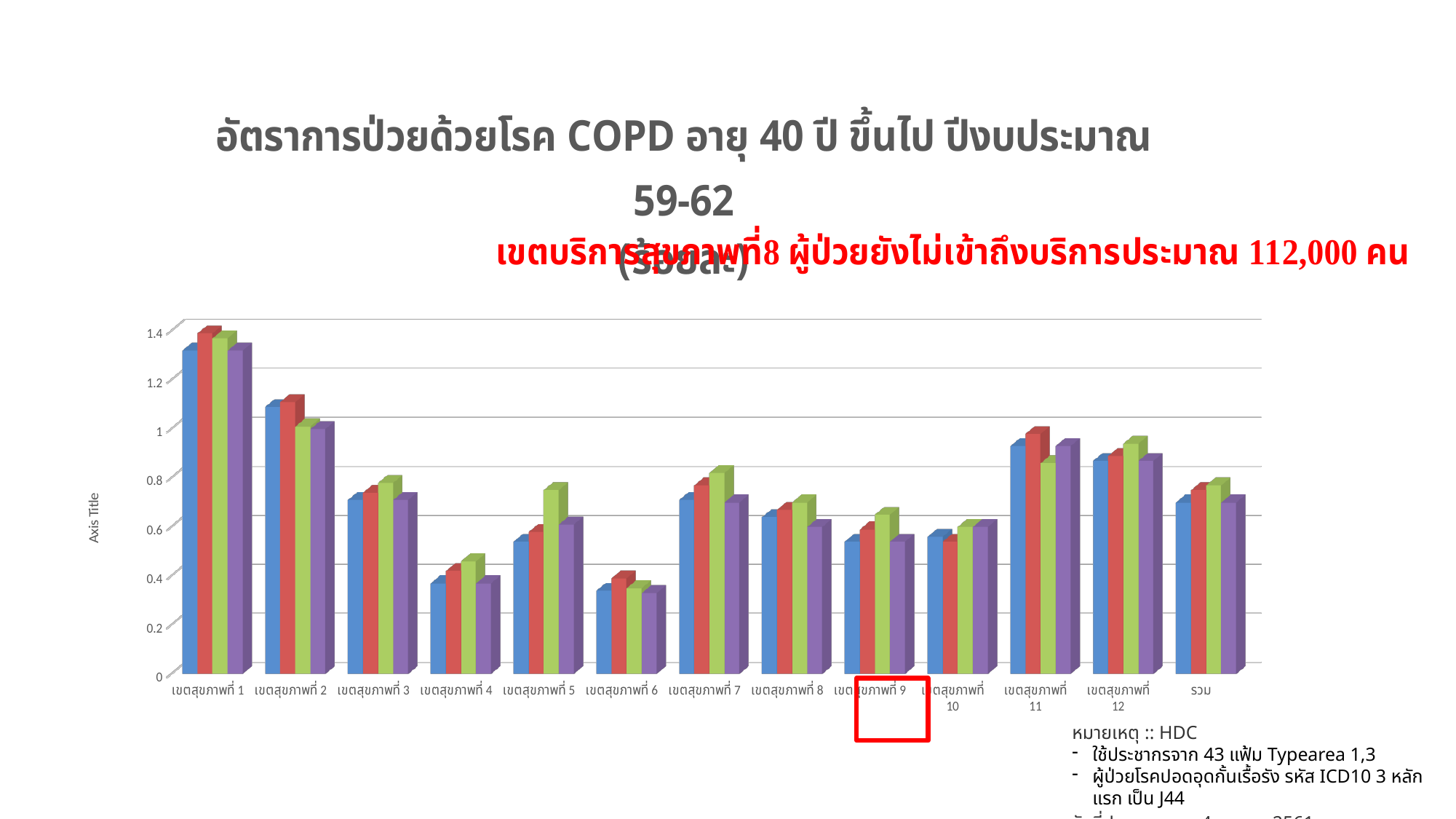
Which category has the lowest green (third) bar in the chart? เขตสุขภาพที่ 6 Which category has the highest bars in the chart? เขตสุขภาพที่ 1 How many categories are shown along the x axis of the chart? 13 Is the blue (first) bar for เขตสุขภาพที่ 11 greater or less than 0.8? greater Is the blue (first) bar for เขตสุขภาพที่ 1 greater or less than 1.2? greater How many bars are plotted for each category in the chart? 4 What is the title shown on the vertical axis of the chart? Axis Title Which has the larger blue (first) bar, เขตสุขภาพที่ 3 or เขตสุขภาพที่ 4? เขตสุขภาพที่ 3 Is the blue (first) bar for เขตสุขภาพที่ 6 greater or less than 0.4? less What kind of chart is shown on the slide? bar chart Which has the larger green (third) bar, เขตสุขภาพที่ 7 or เขตสุขภาพที่ 8? เขตสุขภาพที่ 7